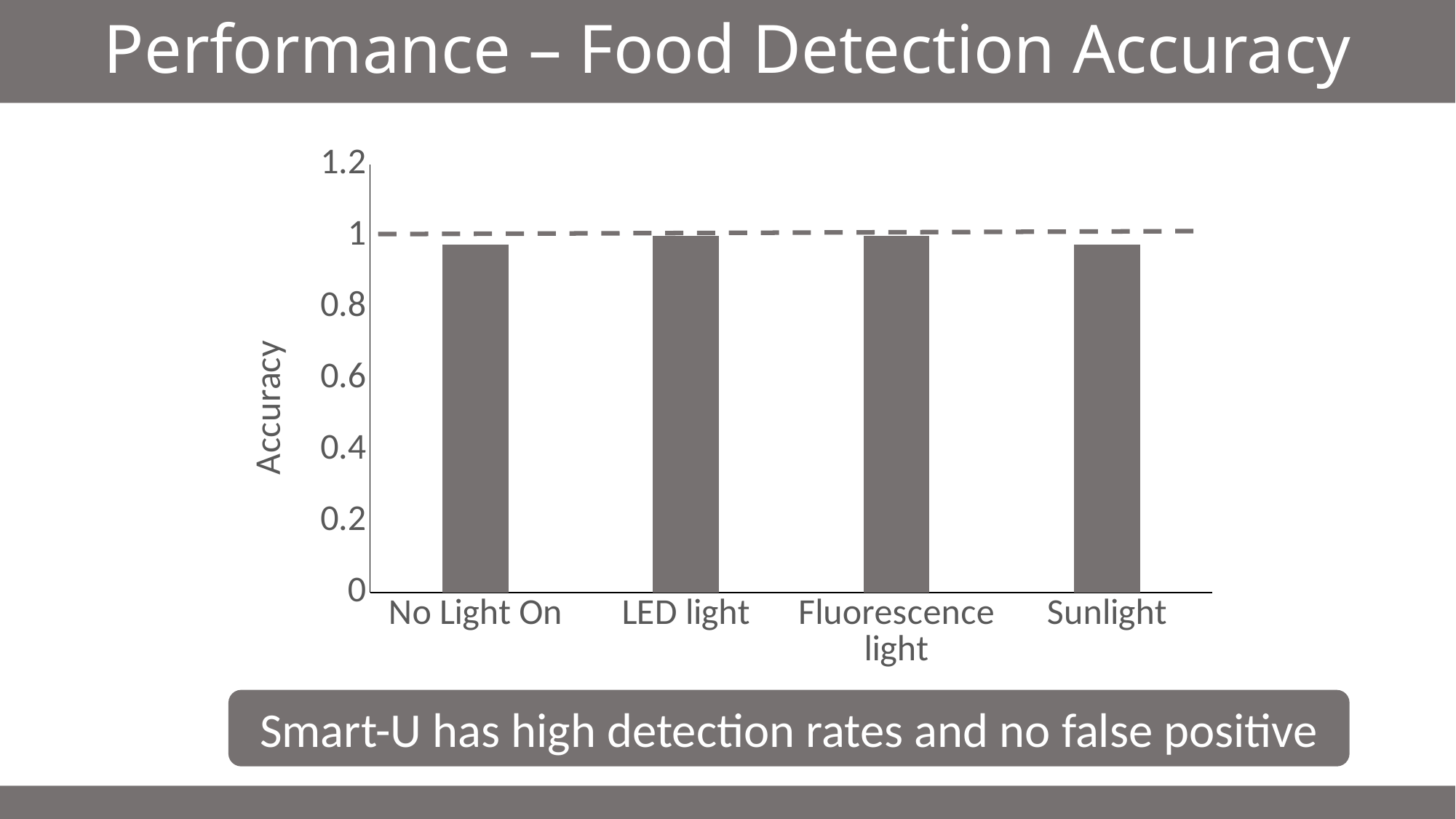
What is the title of the slide containing the chart? Performance – Food Detection Accuracy Is the value for LED light greater or less than 0.6? greater What kind of chart is shown on the slide? bar chart Is the value for Sunlight greater or less than 0.4? greater How many categories are shown on the x axis of the chart? 4 What is the label of the y axis of the chart? Accuracy Is the value for Sunlight greater or less than 0.8? greater What is the highest value shown on the y axis of the chart? 1.2